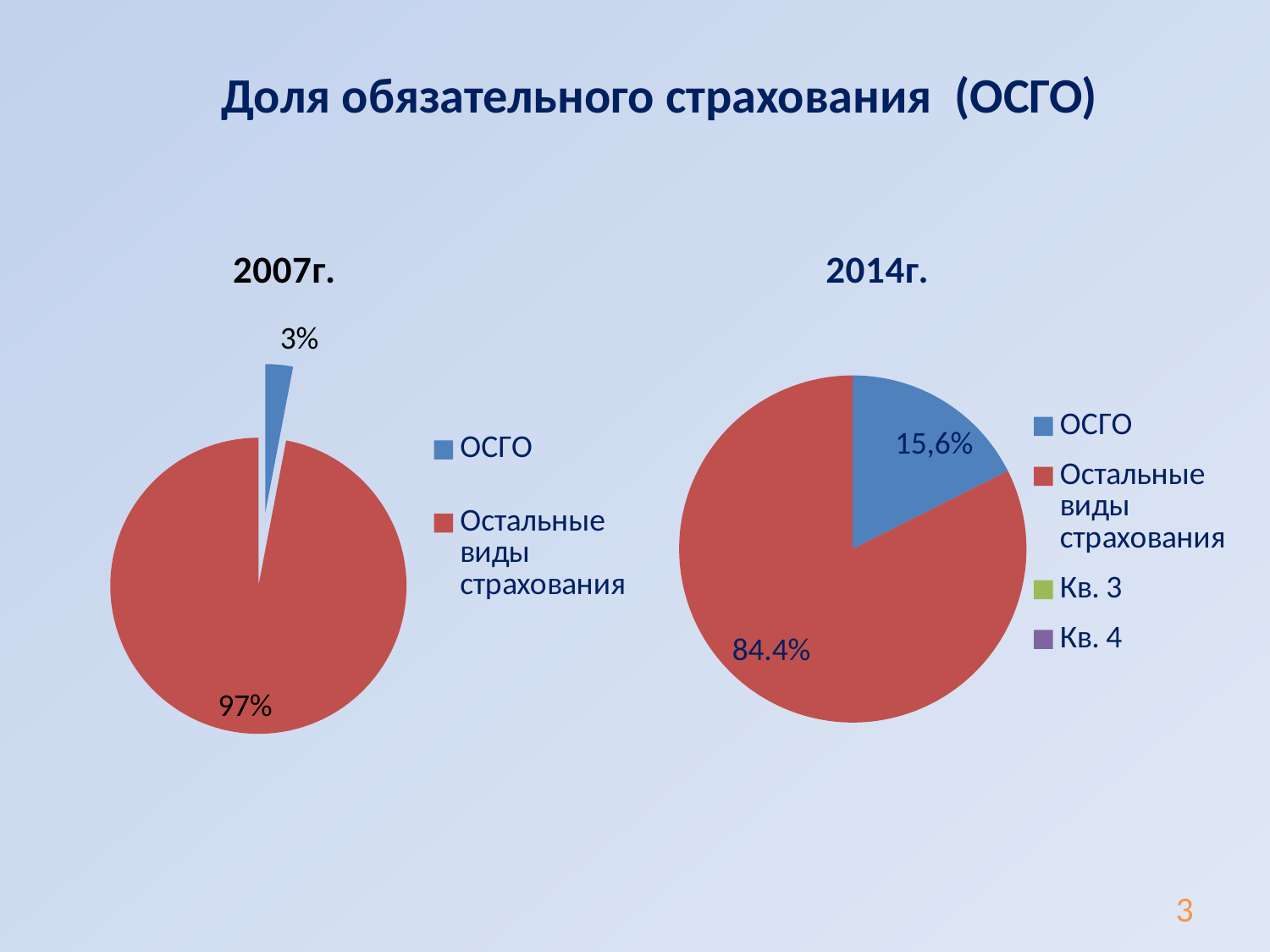
In the 2014г. pie chart, what is the share for ОСГО? 15,6% In the 2007г. pie chart, what is the share for ОСГО? 3% In the 2007г. pie chart, what is the share for Остальные виды страхования? 97% How many slices does the 2007г. pie chart have? 2 In the 2014г. chart, which category has the smallest slice? ОСГО Which is larger: the ОСГО share in the 2007г. chart or the ОСГО share in the 2014г. chart? 2014г. How many entries does the legend of the 2014г. chart list? 4 In the 2007г. chart, what is the difference between the Остальные виды страхования share and the ОСГО share? 94% In the 2014г. chart, what colour is the ОСГО slice? Blue In the 2014г. pie chart, what is the share for Остальные виды страхования? 84.4% In the 2007г. chart, which category has the largest slice? Остальные виды страхования What type of chart is used for the 2014г. data? Pie chart